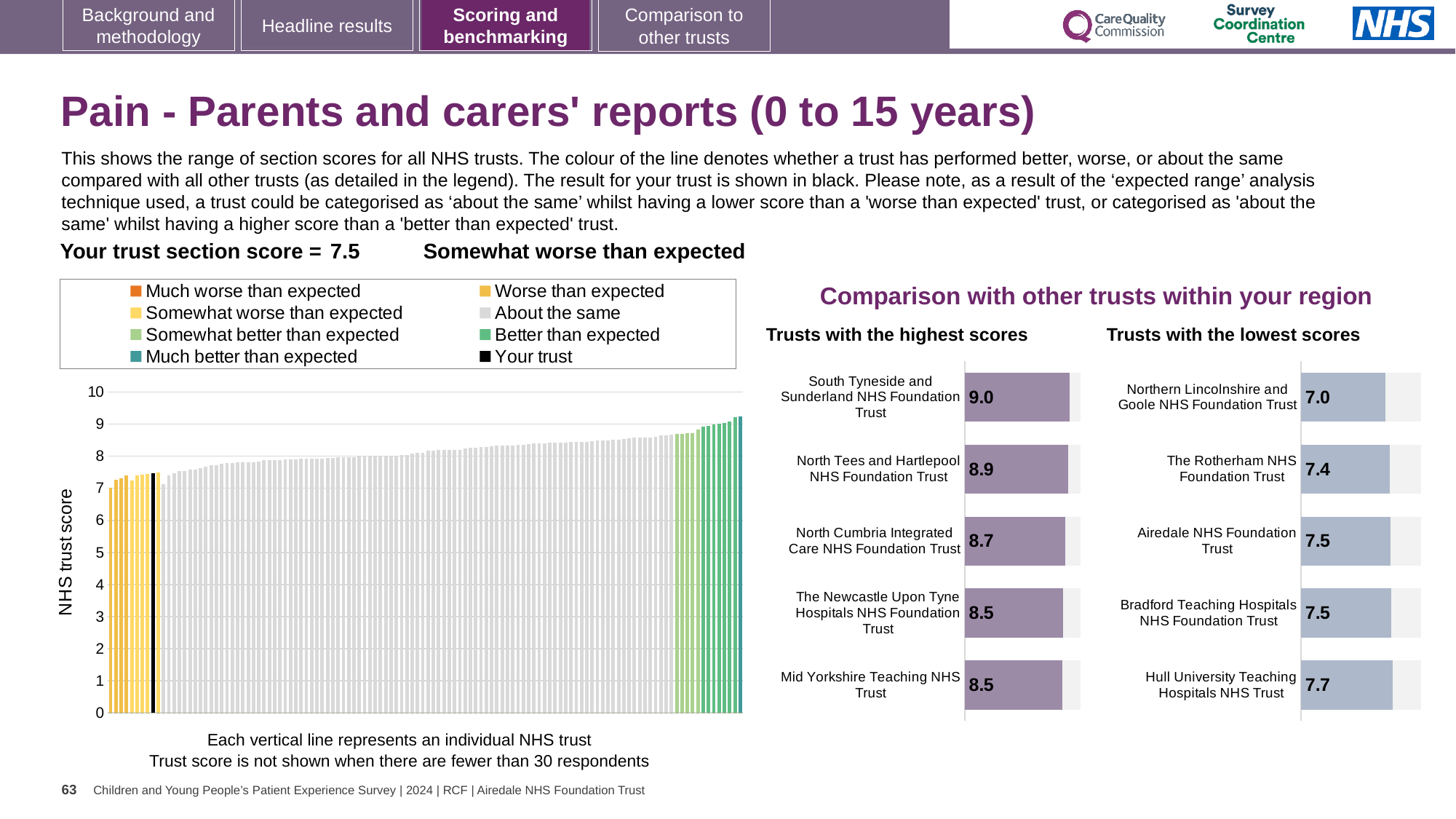
In the 'Trusts with the highest scores' chart, which trust has the highest score? South Tyneside and Sunderland NHS Foundation Trust In the 'Trusts with the highest scores' chart, what is the score for North Cumbria Integrated Care NHS Foundation Trust? 8.7 In the 'Trusts with the highest scores' chart, what is the score for South Tyneside and Sunderland NHS Foundation Trust? 9.0 How many entries does the legend of the large 'NHS trust score' chart on the left list? 8 In the 'Trusts with the lowest scores' chart, what is the score for Northern Lincolnshire and Goole NHS Foundation Trust? 7.0 In the 'Trusts with the lowest scores' chart, what is the score for Hull University Teaching Hospitals NHS Trust? 7.7 In the 'Trusts with the lowest scores' chart, which trust has the lowest score? Northern Lincolnshire and Goole NHS Foundation Trust In the large 'NHS trust score' chart on the left, do the bar values rise or fall from left to right? Rise How many trusts are shown in the 'Trusts with the lowest scores' chart? 5 What is the difference between the score for South Tyneside and Sunderland NHS Foundation Trust in the 'Trusts with the highest scores' chart and the score for Northern Lincolnshire and Goole NHS Foundation Trust in the 'Trusts with the lowest scores' chart? 2.0 What kind of chart is the large chart on the left with the 'NHS trust score' axis? Bar chart In the 'Trusts with the highest scores' chart, which has the larger score: North Tees and Hartlepool NHS Foundation Trust or North Cumbria Integrated Care NHS Foundation Trust? North Tees and Hartlepool NHS Foundation Trust